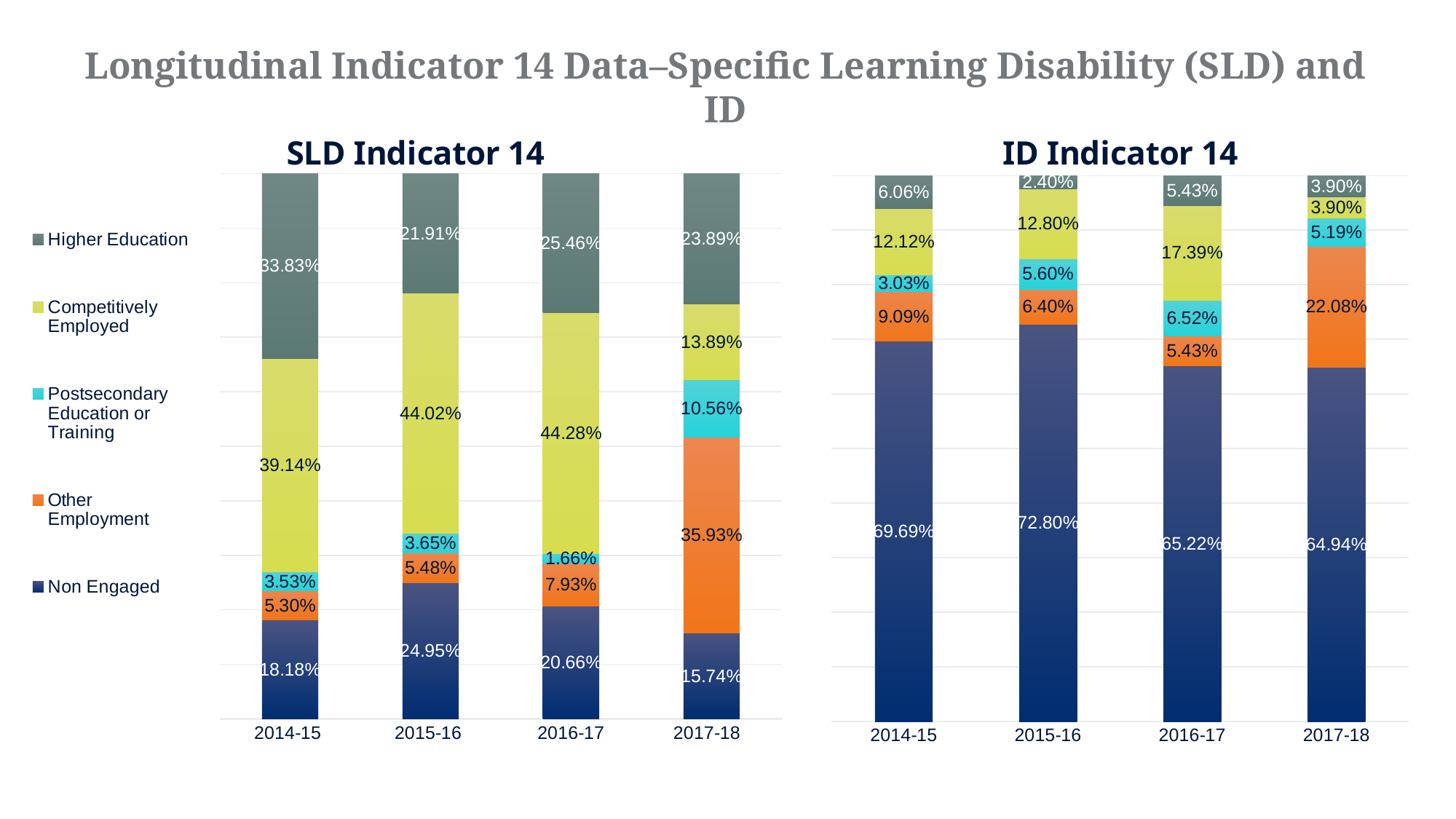
How many series does the legend list? 5 How many years are shown on the x axis of the ID Indicator 14 chart? 4 In the ID Indicator 14 chart, what is the Competitively Employed value for 2016-17? 17.39% In the SLD Indicator 14 chart, which is larger for 2015-16: Non Engaged or Higher Education? Non Engaged In the ID Indicator 14 chart, which year has the lowest Non Engaged value? 2017-18 In the SLD Indicator 14 chart, which year has the highest Competitively Employed value? 2016-17 In the SLD Indicator 14 chart, what is the Higher Education value for 2014-15? 33.83% In the SLD Indicator 14 chart, what is the difference between the Competitively Employed values for 2016-17 and 2017-18? 30.39 percentage points In the ID Indicator 14 chart, what is the difference between the Non Engaged values for 2015-16 and 2017-18? 7.86 percentage points In the ID Indicator 14 chart, what is the Non Engaged value for 2015-16? 72.80% In the SLD Indicator 14 chart, what is the Other Employment value for 2017-18? 35.93% What kind of chart is the SLD Indicator 14 chart? Stacked bar chart